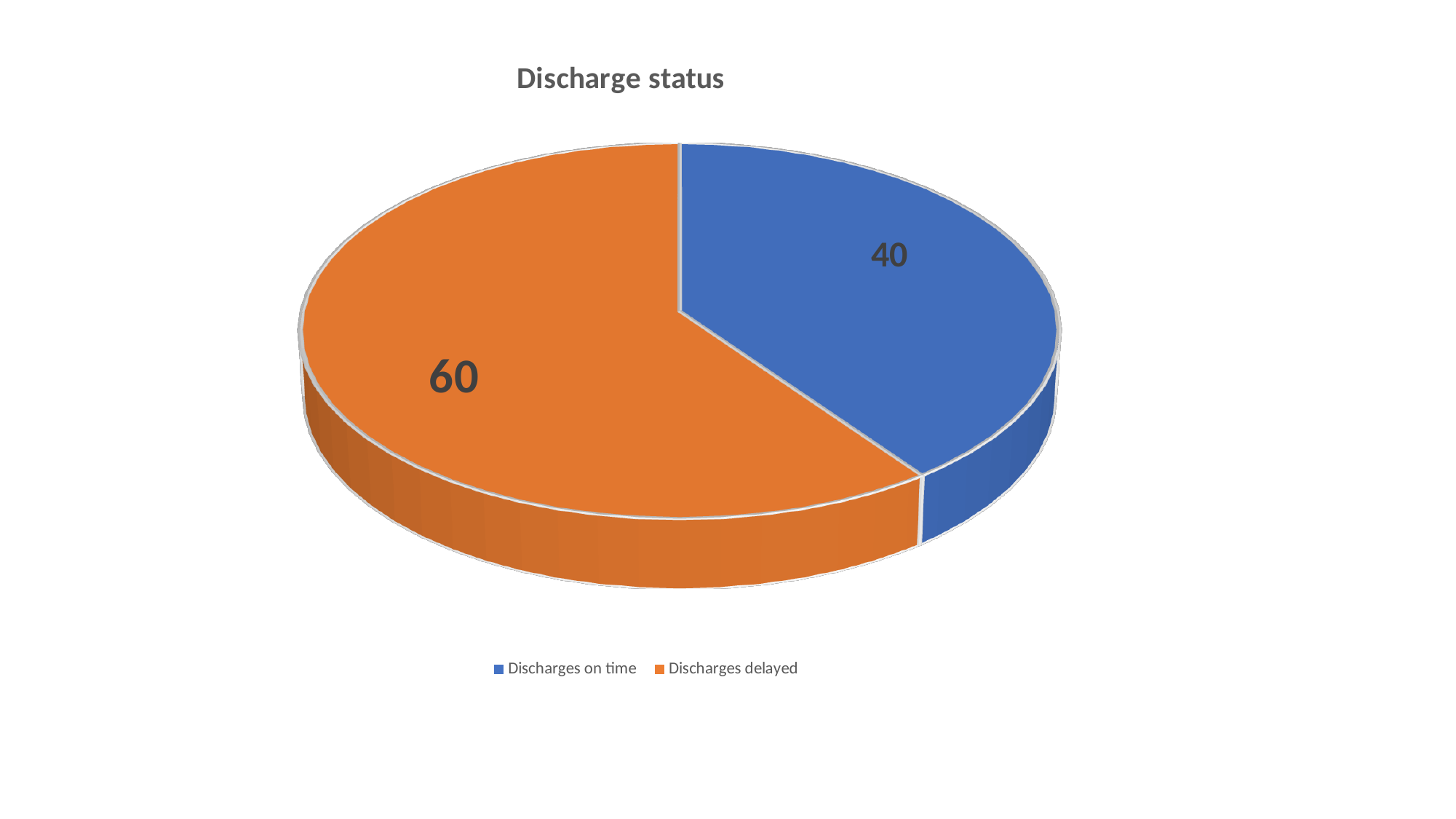
Which category has the smallest slice? Discharges on time Which category has the largest slice? Discharges delayed What is the total of the two slices? 100 Which is larger, Discharges on time or Discharges delayed? Discharges delayed What colour is the Discharges on time slice? Blue What is the value for Discharges delayed? 60 How many slices does the pie chart have? 2 What is the value for Discharges on time? 40 What is the title of the chart? Discharge status What share of the pie does Discharges delayed represent? 60% What kind of chart is shown? Pie chart What is the difference between the values for Discharges delayed and Discharges on time? 20